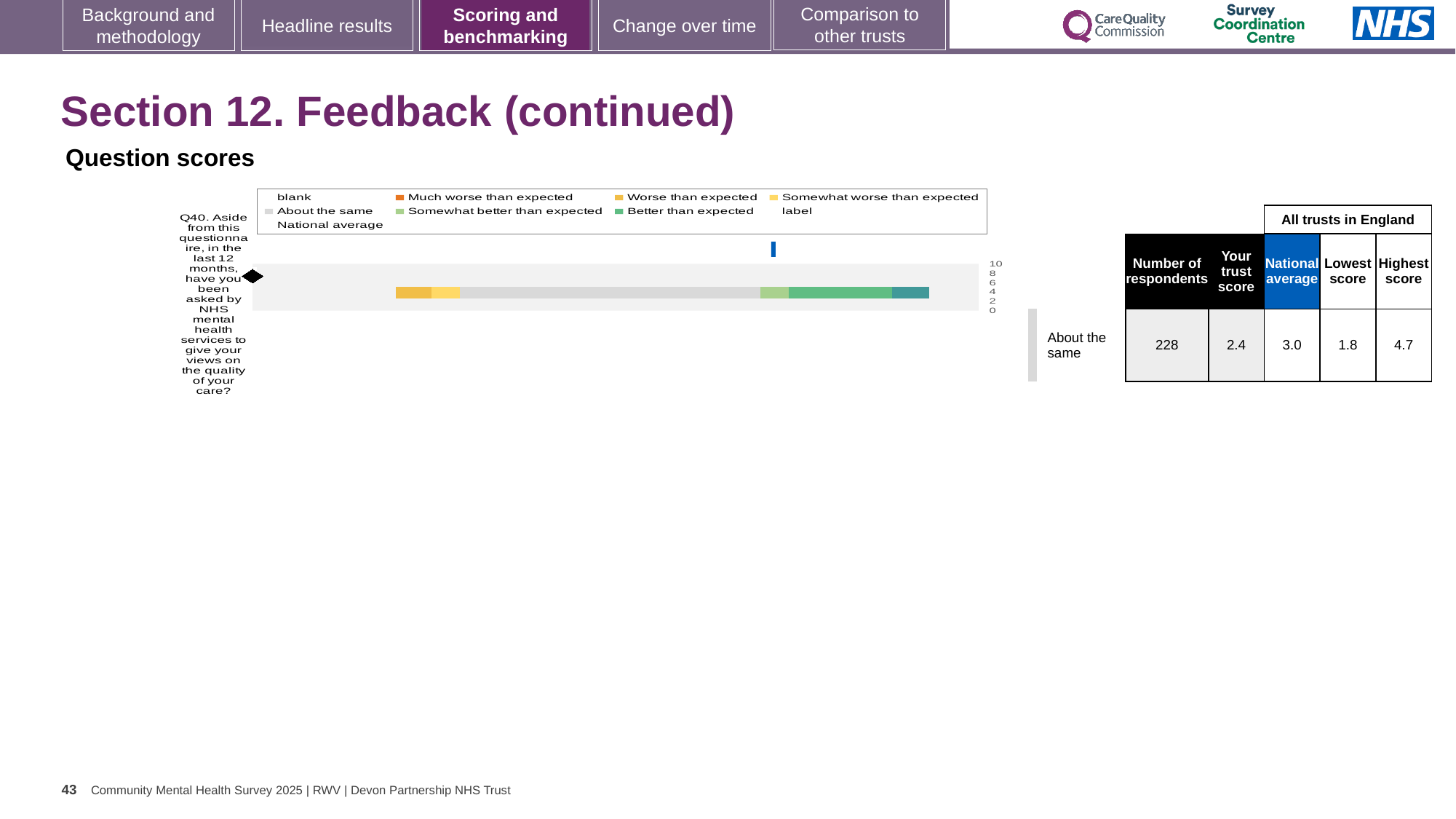
What is the trust's score for Q40? 2.4 What is the national average score for Q40? 3.0 What is the lowest score among all trusts in England for Q40? 1.8 What benchmark category is shown for Q40 next to the chart? About the same What is the difference between the highest and lowest scores among all trusts in England for Q40? 2.9 How many entries does the legend of the Question scores chart list? 9 What kind of chart is shown under 'Question scores'? bar chart What is the highest score among all trusts in England for Q40? 4.7 How many questions (categories) are plotted in the Question scores chart? 1 What is the number of respondents for Q40? 228 Which question is plotted in the Question scores chart? Q40. Aside from this questionnaire, in the last 12 months, have you been asked by NHS mental health services to give your views on the quality of your care? Which is larger for Q40, the trust score or the national average? national average